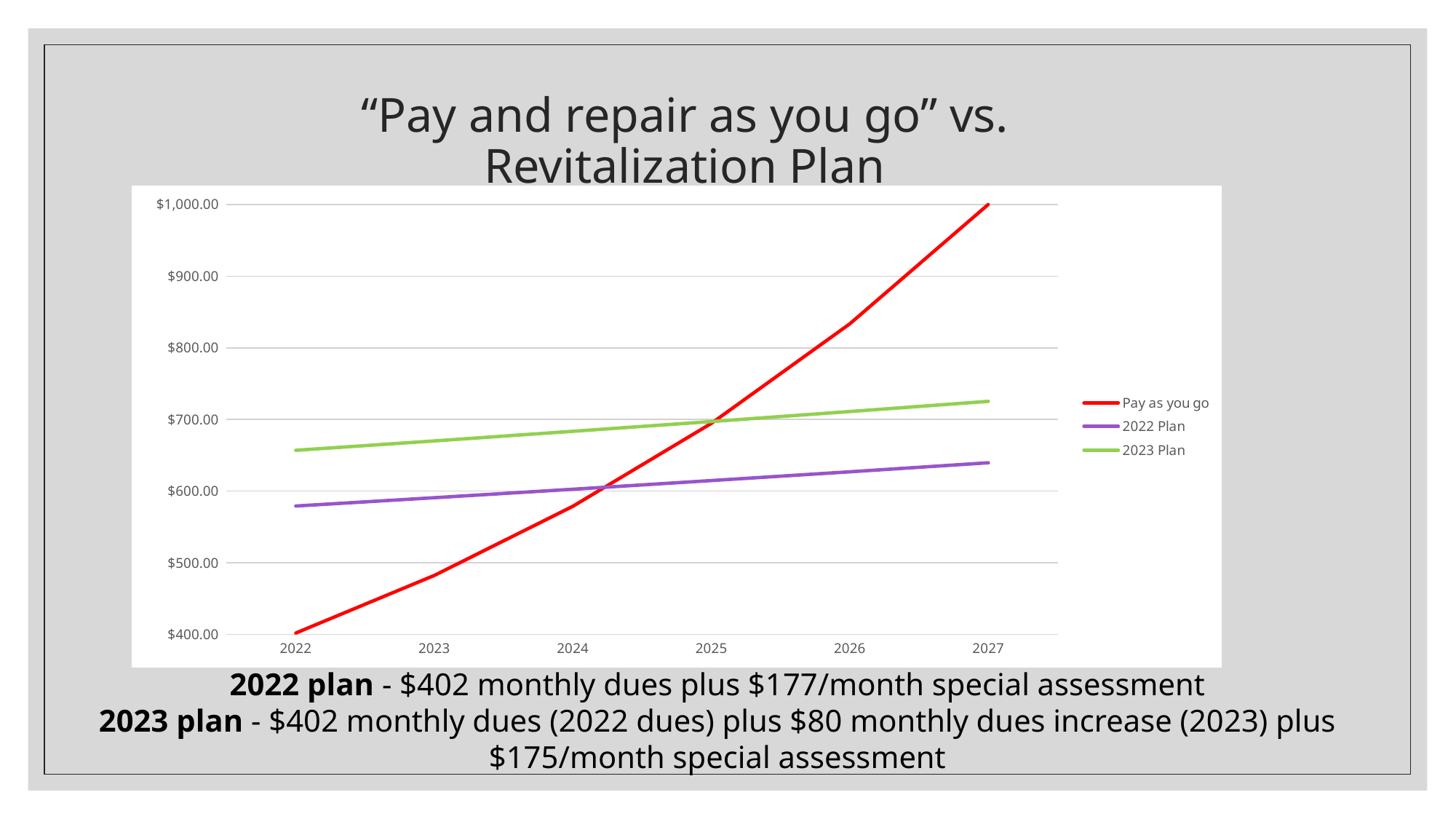
Is the value for 2023 Plan in 2022 greater or less than $600.00? greater What kind of chart is shown on the slide? line chart Does the Pay as you go line rise or fall from 2022 to 2027? rises How many series does the legend list? 3 Which series has the lowest value in 2022? Pay as you go Which series has the highest value in 2027? Pay as you go Is the value for Pay as you go in 2026 greater or less than $800.00? greater Is the value for Pay as you go in 2023 greater or less than $500.00? less How many years are shown along the x axis? 6 What colour is the line for the 2023 Plan series? green In 2022, which is larger: the 2023 Plan value or the Pay as you go value? 2023 Plan